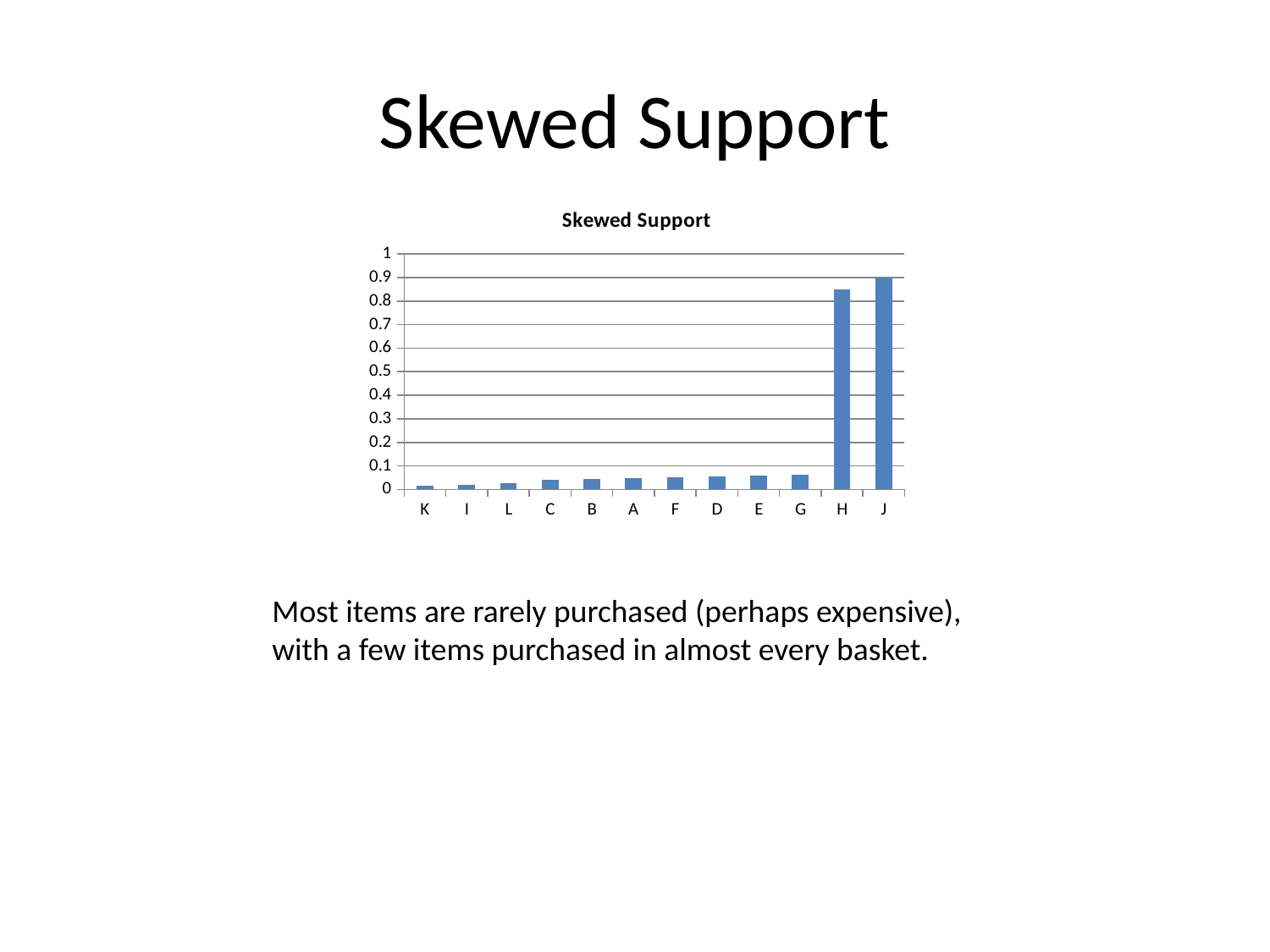
Is the value for J greater or less than 0.5? greater Which has the larger value, K or G? G How many categories are shown on the x axis of the chart? 12 What kind of chart is shown on the slide? bar chart What is the first category label on the x axis of the chart? K What is the title of the chart? Skewed Support Is the value for H greater or less than 0.8? greater Which category has the lowest value in the chart? K Is the value for G greater or less than 0.1? less Which has the larger value, H or J? J Which category has the highest value in the chart? J Do the values generally rise or fall moving from left to right along the x axis? rise